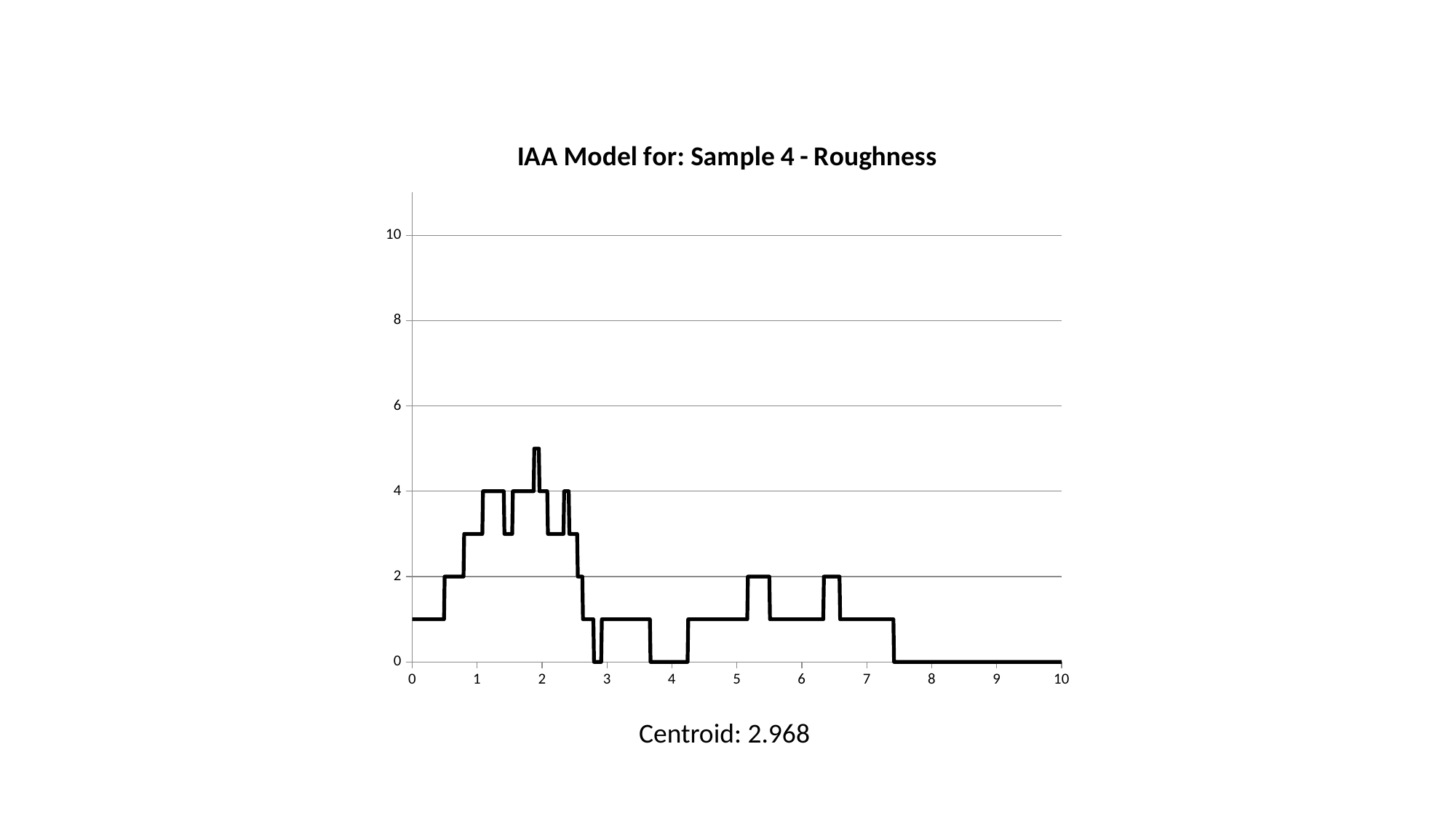
What is the value of the line at x = 9? 0 Does the line rise or fall between x = 2 and x = 4? fall What is the value of the line at x = 0.6? 2 Which is larger: the value of the line at x = 1 or at x = 5? x = 1 What kind of chart is shown on the slide? line chart What centroid value is printed below the chart? 2.968 Is the value of the line at x = 3 greater or less than 2? less What is the value of the line at x = 5.3? 2 Is the highest point of the line greater or less than 4? greater How many lines are plotted on the chart? 1 What is the title of the chart? IAA Model for: Sample 4 - Roughness What is the value of the line at x = 1.2? 4